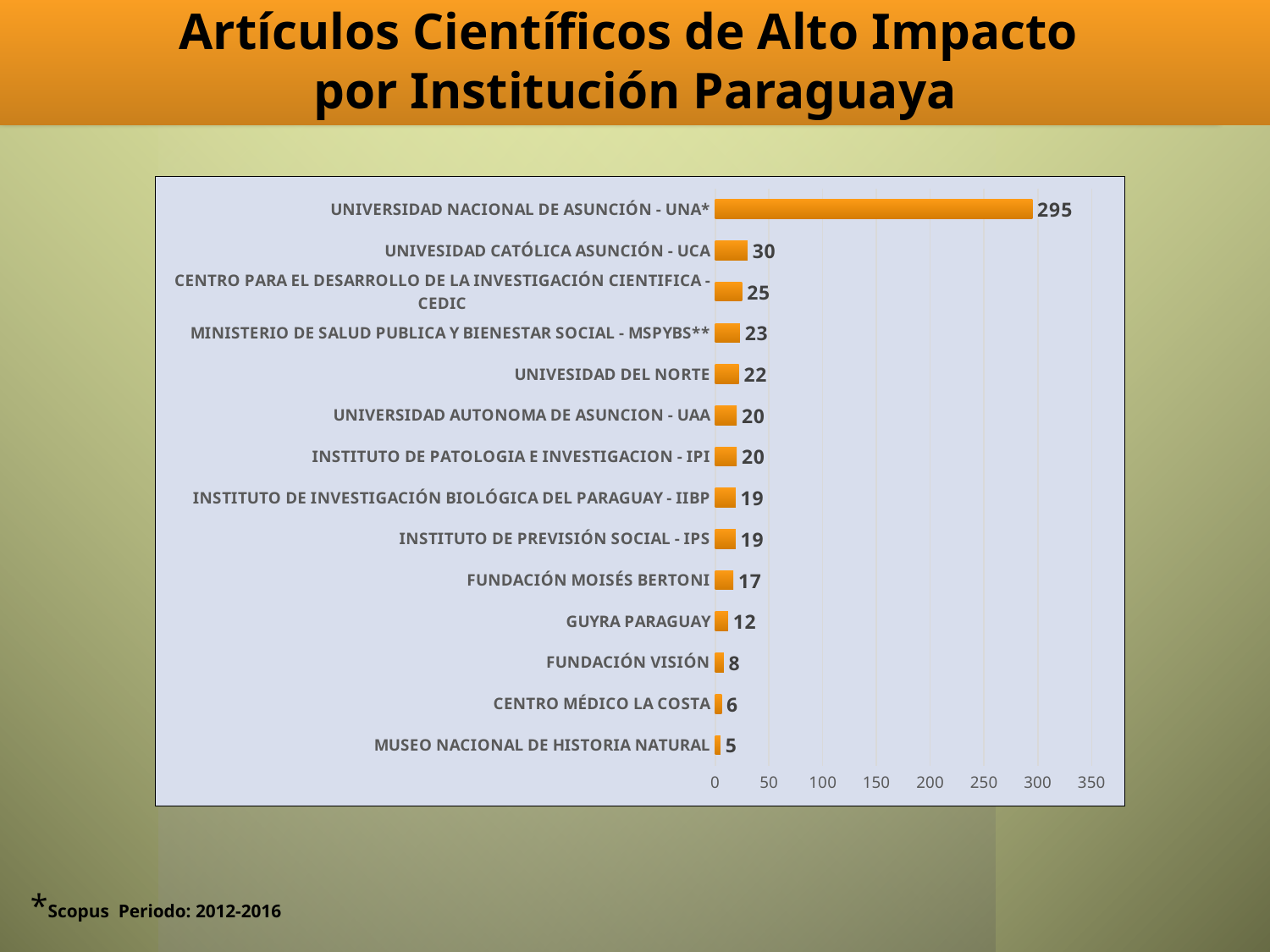
Which is larger, the value for MINISTERIO DE SALUD PUBLICA Y BIENESTAR SOCIAL - MSPYBS** or the value for UNIVESIDAD DEL NORTE? MINISTERIO DE SALUD PUBLICA Y BIENESTAR SOCIAL - MSPYBS** What is the title of the slide? Artículos Científicos de Alto Impacto por Institución Paraguaya What kind of chart is shown on the slide? bar chart Which institution has the lowest value? MUSEO NACIONAL DE HISTORIA NATURAL What is the value for FUNDACIÓN MOISÉS BERTONI? 17 How many institutions are shown in the chart? 14 What is the difference between the values for UNIVERSIDAD NACIONAL DE ASUNCIÓN - UNA* and UNIVESIDAD CATÓLICA ASUNCIÓN - UCA? 265 What is the difference between the values for GUYRA PARAGUAY and FUNDACIÓN VISIÓN? 4 What is the value for UNIVERSIDAD NACIONAL DE ASUNCIÓN - UNA*? 295 Which institution has the highest value? UNIVERSIDAD NACIONAL DE ASUNCIÓN - UNA* Is the value for UNIVERSIDAD NACIONAL DE ASUNCIÓN - UNA* greater or less than 250? greater What is the value for CENTRO PARA EL DESARROLLO DE LA INVESTIGACIÓN CIENTIFICA - CEDIC? 25